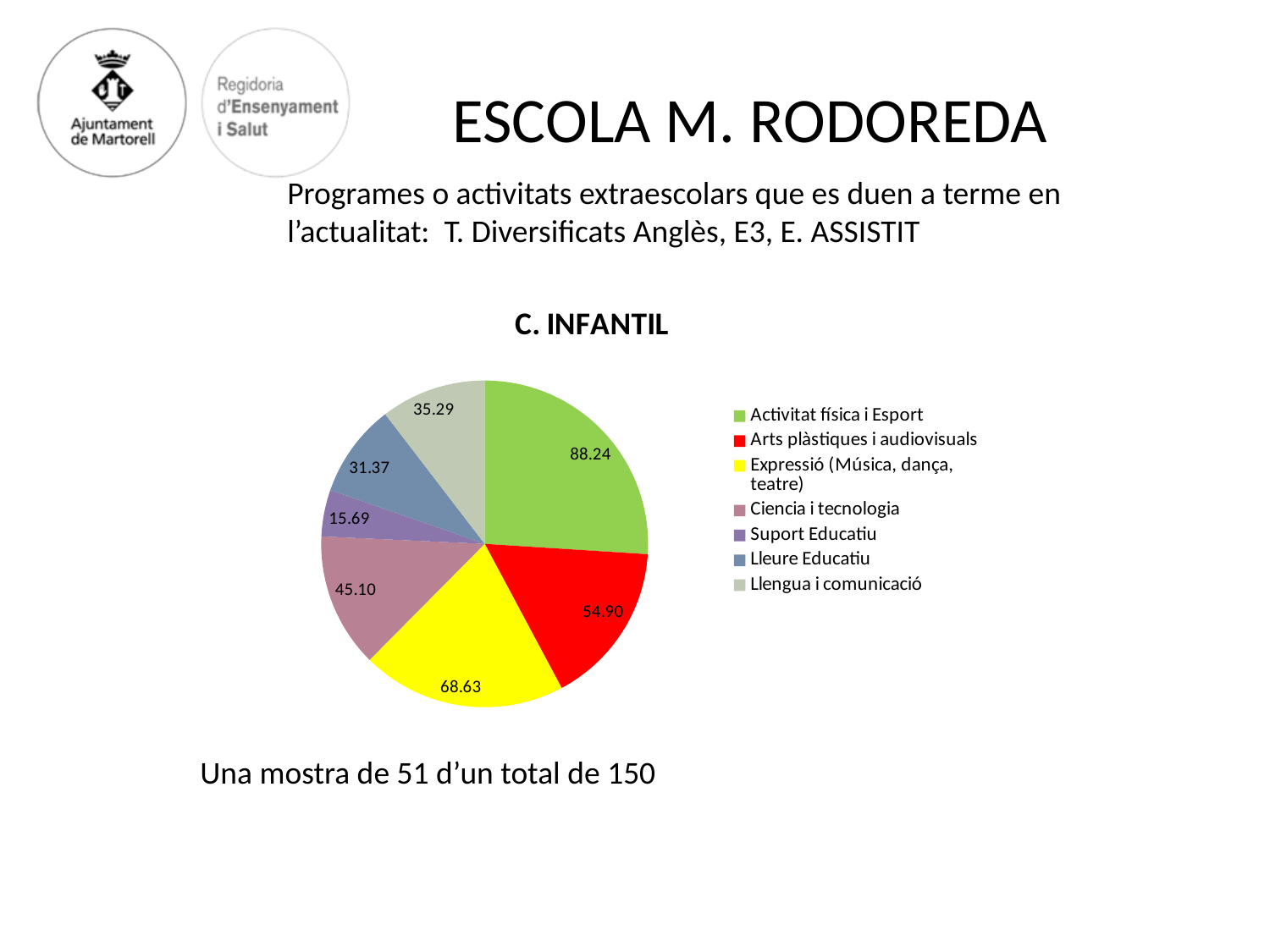
What is the title of the chart? C. INFANTIL What colour is the slice for Expressió (Música, dança, teatre)? yellow What is the value for Expressió (Música, dança, teatre)? 68.63 What is the value for Arts plàstiques i audiovisuals? 54.90 Which is larger, the value for Ciencia i tecnologia or the value for Lleure Educatiu? Ciencia i tecnologia How many categories does the pie chart have? 7 Which category has the largest slice of the pie? Activitat física i Esport What is the value for Suport Educatiu? 15.69 What is the value for Activitat física i Esport? 88.24 What is the difference between the values for Activitat física i Esport and Arts plàstiques i audiovisuals? 33.34 Which category has the smallest slice of the pie? Suport Educatiu What type of chart is shown on the slide? pie chart